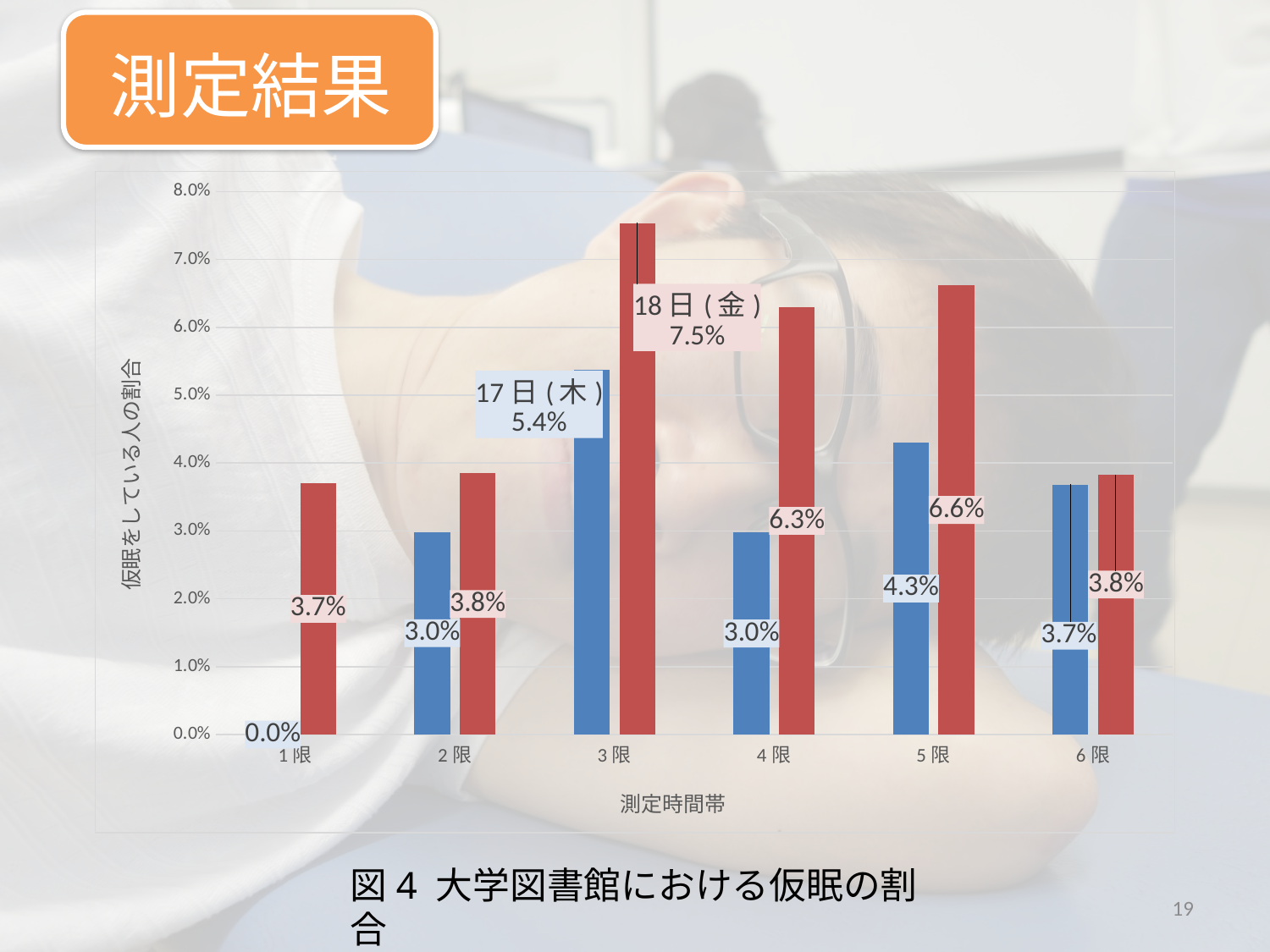
Which is larger at 4限: the value for 17日(木) or for 18日(金)? 18日(金) Which time slot has the highest value for 18日(金)? 3限 How many time-slot categories (限) are shown on the x axis? 6 Which time slot has the lowest value for 17日(木)? 1限 What is the value for 17日(木) at 3限? 5.4% What is the label of the x axis? 測定時間帯 What is the difference between the 18日(金) and 17日(木) values at 3限? 2.1% What is the value for 18日(金) at 5限? 6.6% What is the value for 17日(木) at 1限? 0.0% What is the value for 18日(金) at 3限? 7.5% What is the label of the y axis? 仮眠をしている人の割合 What type of chart is shown on the slide? bar chart